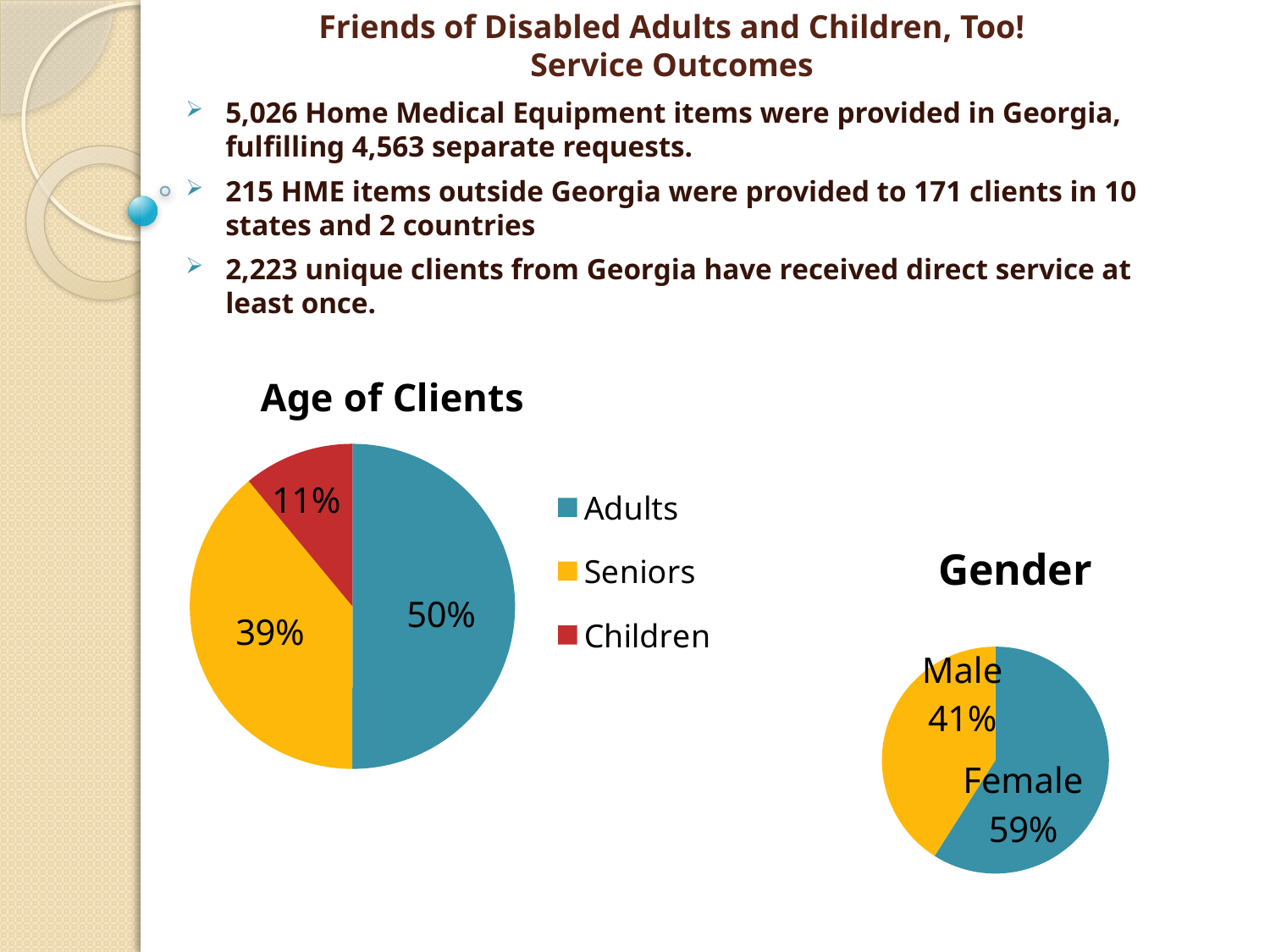
In the "Age of Clients" chart, how many categories does the legend list? 3 In the "Gender" chart, what share of clients are Male? 41% In the "Age of Clients" chart, what share of clients are Children? 11% In the "Age of Clients" chart, which category has the largest share? Adults In the "Gender" chart, what is the difference in percentage points between Female and Male? 18 In the "Age of Clients" chart, what share of clients are Adults? 50% What kind of chart is the "Age of Clients" chart? Pie chart In the "Age of Clients" chart, what is the difference in percentage points between Seniors and Children? 28 In the "Age of Clients" chart, which category has the smallest share? Children In the "Age of Clients" chart, what share of clients are Seniors? 39% In the "Gender" chart, which is larger, the Male share or the Female share? Female In the "Gender" chart, what share of clients are Female? 59%